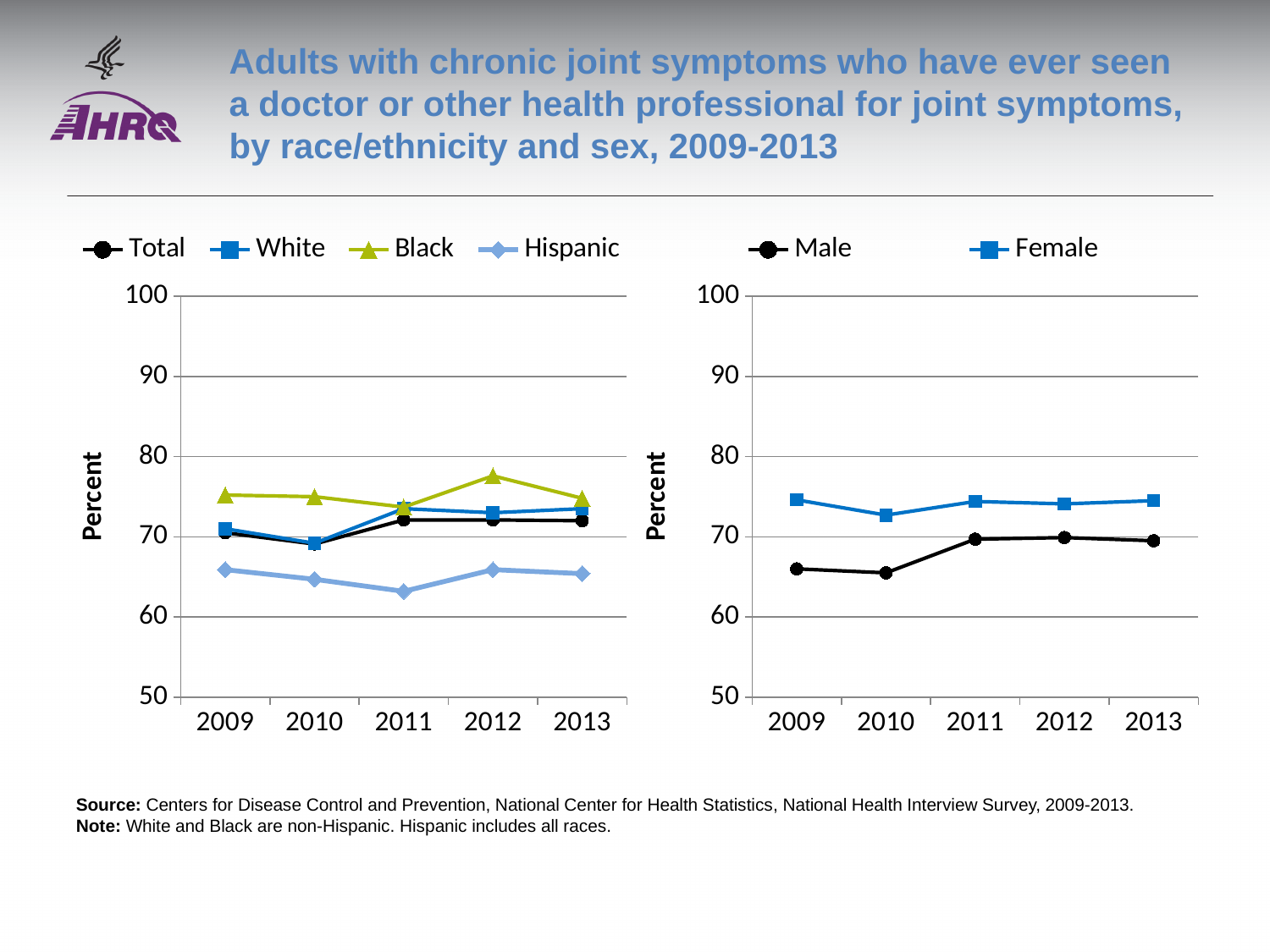
What kind of chart is the left chart (Total, White, Black, Hispanic)? line chart In the left chart, is the value for Hispanic in 2011 greater or less than 70? less In the left chart, is the value for Black in 2012 greater or less than 70? greater In the right chart (Male, Female), how many years are plotted on the x axis? 5 In the right chart, which is larger in 2010, the value for Male or the value for Female? Female What is the label on the vertical axis of the left chart? Percent In the right chart, does the value for Male rise or fall from 2010 to 2011? rise In the right chart, is the value for Male in 2009 greater or less than 70? less In the left chart, which group has the highest value in 2012? Black In the right chart (Male, Female), how many series does the legend list? 2 In the left chart, how many series does the legend list? 4 In the left chart, which group has the lowest value in 2013? Hispanic